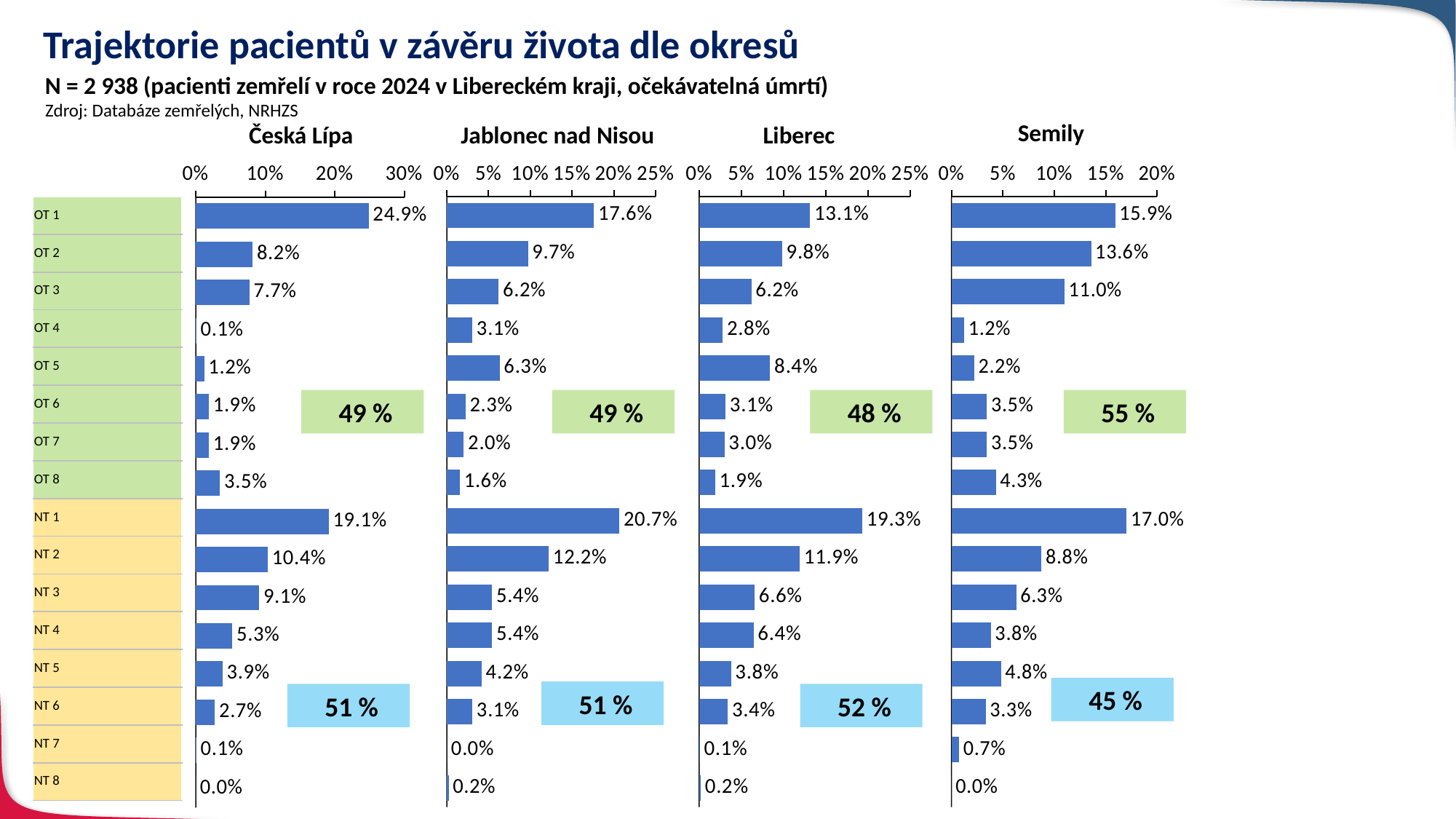
In the Liberec chart, which category has the lowest value? NT 7 How many categories are plotted in the Liberec chart? 16 In the Semily chart, what is the value for NT 1? 17.0% In the Česká Lípa chart, what is the value for OT 1? 24.9% What percentage is shown in the green box in the Semily chart? 55 % In the Česká Lípa chart, is the value for OT 1 greater or less than 20%? greater In the Liberec chart, what is the difference between the values for NT 1 and OT 1? 6.2 percentage points In the Jablonec nad Nisou chart, which category has the highest value? NT 1 What kind of chart is the Semily chart? Bar chart In the Semily chart, which is larger, the value for OT 2 or NT 2? OT 2 In the Česká Lípa chart, which is larger, the value for OT 3 or NT 3? NT 3 In the Jablonec nad Nisou chart, what is the value for OT 5? 6.3%